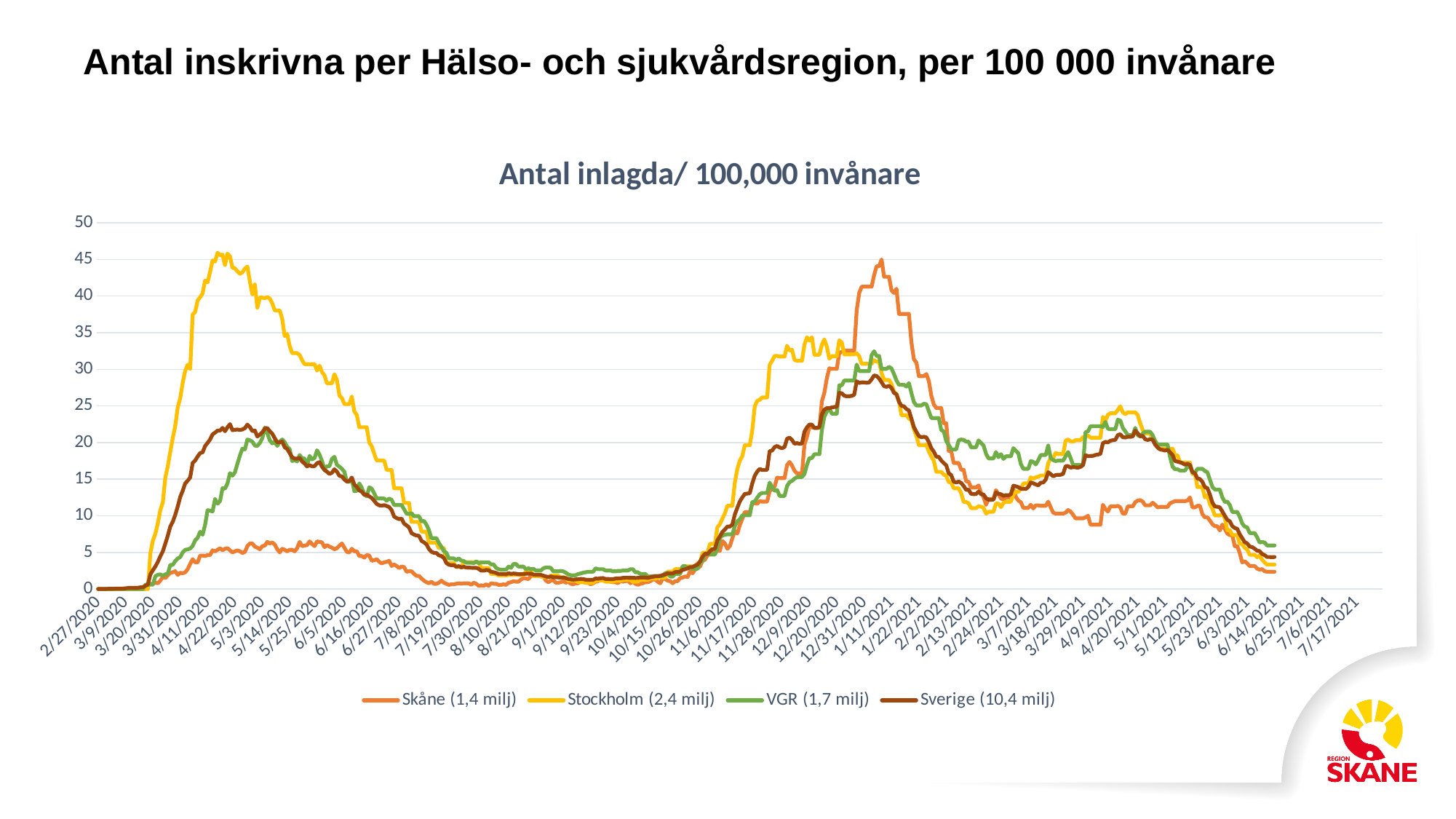
What are the series names listed in the legend? Skåne (1,4 milj), Stockholm (2,4 milj), VGR (1,7 milj), Sverige (10,4 milj) Between 5/3/2020 and 7/19/2020, does the Stockholm series rise or fall? fall Around 4/22/2020, which series has the higher value, Stockholm or Skåne? Stockholm (2,4 milj) Is the peak value for Stockholm in April 2020 greater or less than 40? greater Is the value for Skåne around 4/22/2020 greater or less than 10? less Which series reaches the highest peak around 1/11/2021? Skåne (1,4 milj) How many series does the legend list? 4 Is the peak value for Skåne in January 2021 greater or less than 40? greater Which series reaches the highest peak in spring 2020 (around 4/22/2020)? Stockholm (2,4 milj) What is the title of the chart? Antal inlagda/ 100,000 invånare What kind of chart is shown on the slide? line chart Which series has the lowest value around 4/22/2020? Skåne (1,4 milj)